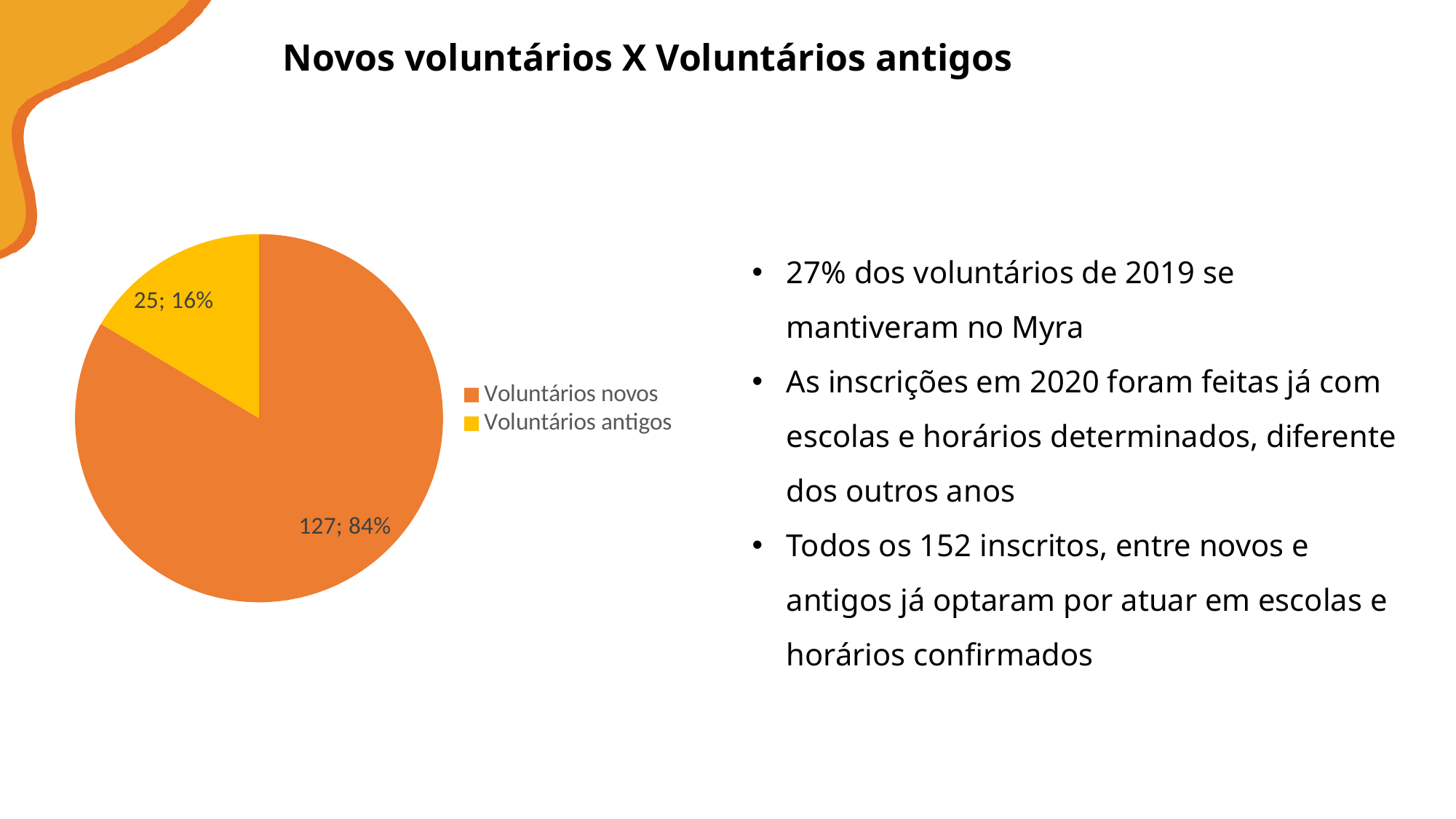
Which slice is the largest? Voluntários novos What is the value for Voluntários antigos? 25 Which is larger, Voluntários novos or Voluntários antigos? Voluntários novos What is the value for Voluntários novos? 127 Which slice is the smallest? Voluntários antigos How many slices does the pie chart have? 2 What kind of chart is shown on the slide? pie chart What colour is the Voluntários antigos slice? yellow How many entries does the legend list? 2 What share of the pie is Voluntários antigos? 16% What share of the pie is Voluntários novos? 84% What is the difference between the values for Voluntários novos and Voluntários antigos? 102